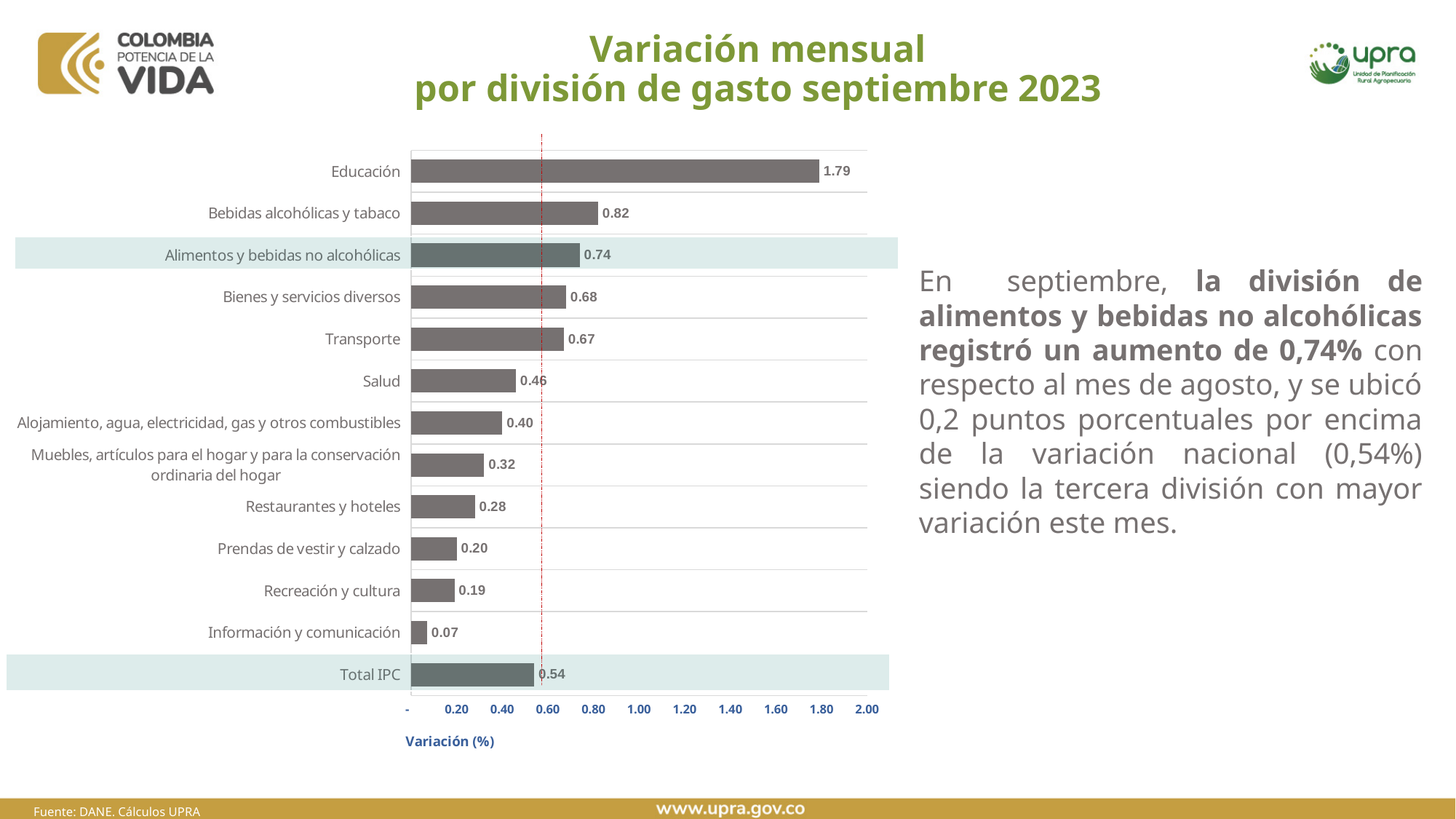
Which is larger, the value for Salud or the value for Transporte? Transporte What is the value for Información y comunicación? 0.07 What is the label of the horizontal axis? Variación (%) What is the value for Total IPC? 0.54 What kind of chart is shown on the slide? Bar chart What is the difference between the values for Alimentos y bebidas no alcohólicas and Total IPC? 0.20 Which category has the highest value? Educación How many categories (bars) are shown in the chart? 13 Which category has the lowest value? Información y comunicación What is the difference between the values for Educación and Bebidas alcohólicas y tabaco? 0.97 What is the value for Educación? 1.79 What is the value for Alimentos y bebidas no alcohólicas? 0.74